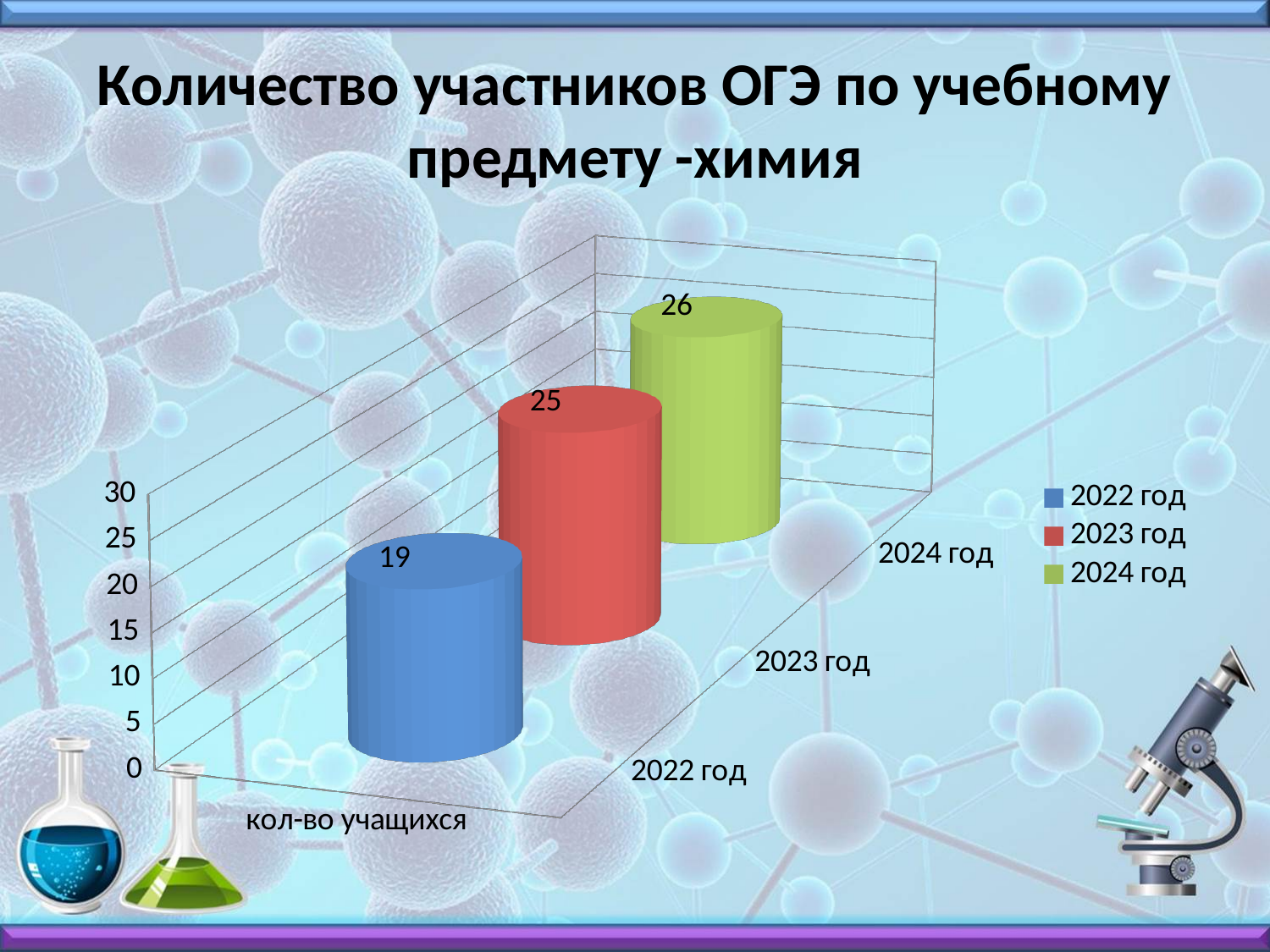
What is the number of participants for 2024 год? 26 What is the number of participants for 2023 год? 25 Is the value for 2022 год greater or less than 20? less Which is larger, the value for 2022 год or the value for 2023 год? 2023 год Which year has the highest number of participants? 2024 год What is the difference between the values for 2024 год and 2022 год? 7 Which year has the lowest number of participants? 2022 год What is the difference between the values for 2023 год and 2022 год? 6 Do the values rise or fall from 2022 год to 2024 год? rise How many series does the legend list? 3 What kind of chart is shown on the slide? bar chart What is the number of participants for 2022 год? 19